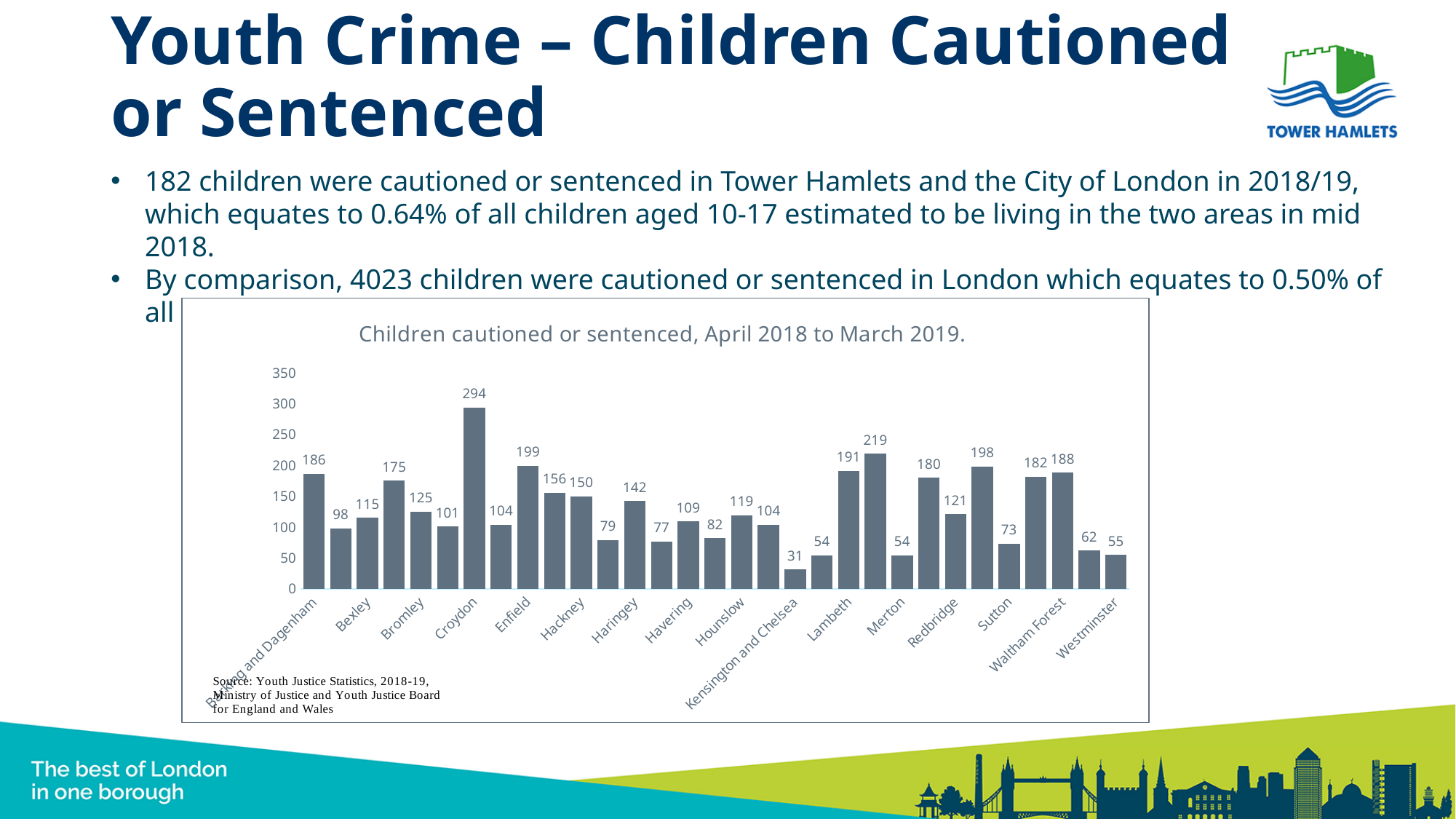
What is the value shown for Westminster? 55 Which labelled borough has the highest number of children cautioned or sentenced? Croydon What is the title of the chart? Children cautioned or sentenced, April 2018 to March 2019. What is the value shown for Enfield? 199 Which has a higher value, Hackney or Haringey? Hackney What is the value shown for Lambeth? 191 Which labelled borough has the lowest number of children cautioned or sentenced? Kensington and Chelsea What is the value shown for Kensington and Chelsea? 31 What is the difference between the values for Croydon and Enfield? 95 How many children were cautioned or sentenced in Croydon according to the chart? 294 What type of chart is shown on the slide? Bar chart Is the value for Waltham Forest greater or less than 150? greater